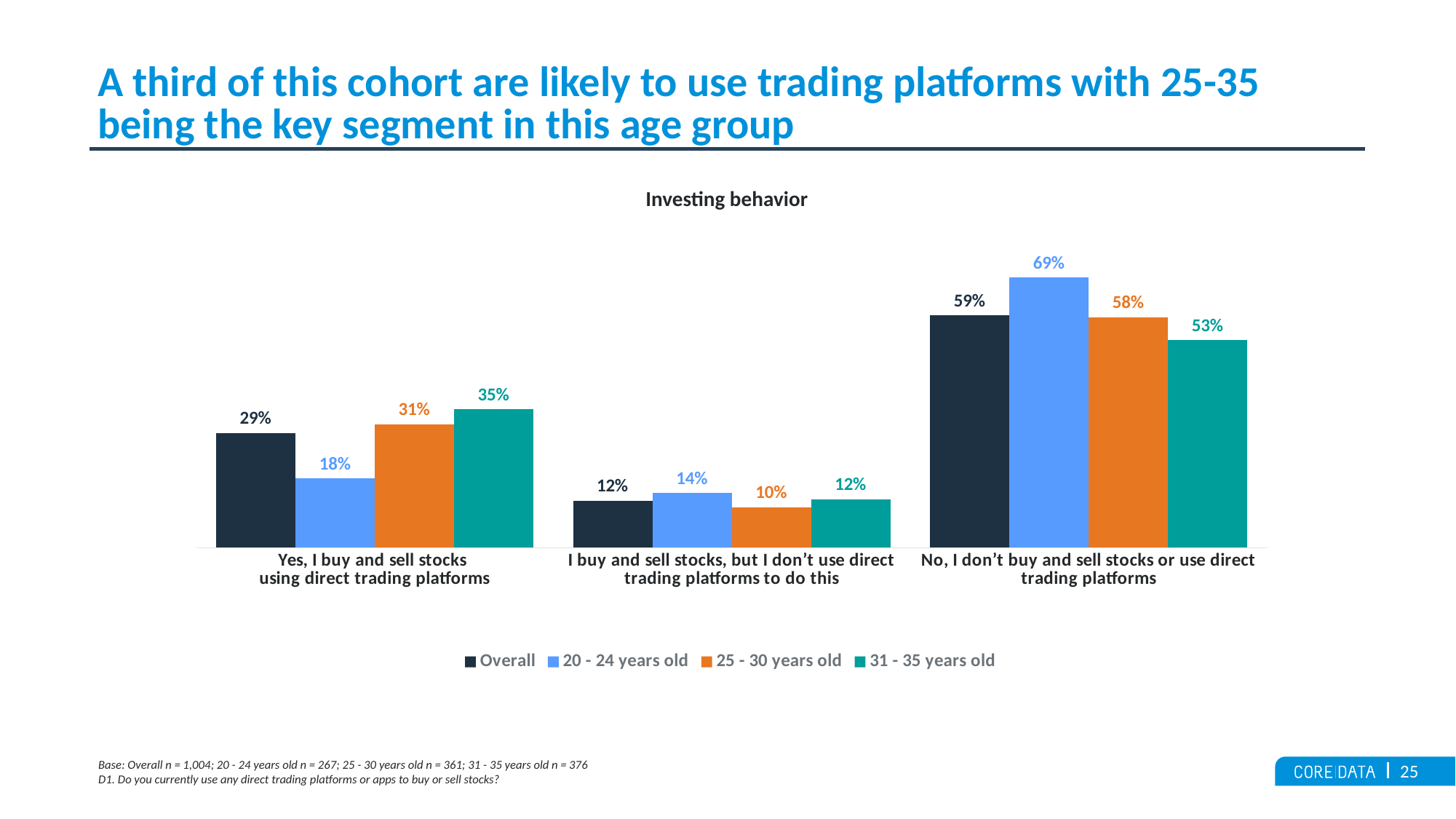
What is the Overall value for "Yes, I buy and sell stocks using direct trading platforms"? 29% Which age group has the highest value for "Yes, I buy and sell stocks using direct trading platforms"? 31 - 35 years old What is the value for 25 - 30 years old in the "I buy and sell stocks, but I don't use direct trading platforms to do this" category? 10% What is the difference between the 31 - 35 years old and 20 - 24 years old values for "Yes, I buy and sell stocks using direct trading platforms"? 17 percentage points What is the title of the chart? Investing behavior Which series has the lowest value in the "No, I don't buy and sell stocks or use direct trading platforms" category? 31 - 35 years old How many series does the legend list? 4 What kind of chart is shown on the slide? Bar chart How many categories are shown on the x axis of the chart? 3 Which colour represents the 25 - 30 years old series in the chart? Orange What is the value for 20 - 24 years old in the "No, I don't buy and sell stocks or use direct trading platforms" category? 69% Which is larger for 25 - 30 years old: the "Yes, I buy and sell stocks using direct trading platforms" value or the "I buy and sell stocks, but I don't use direct trading platforms to do this" value? Yes, I buy and sell stocks using direct trading platforms